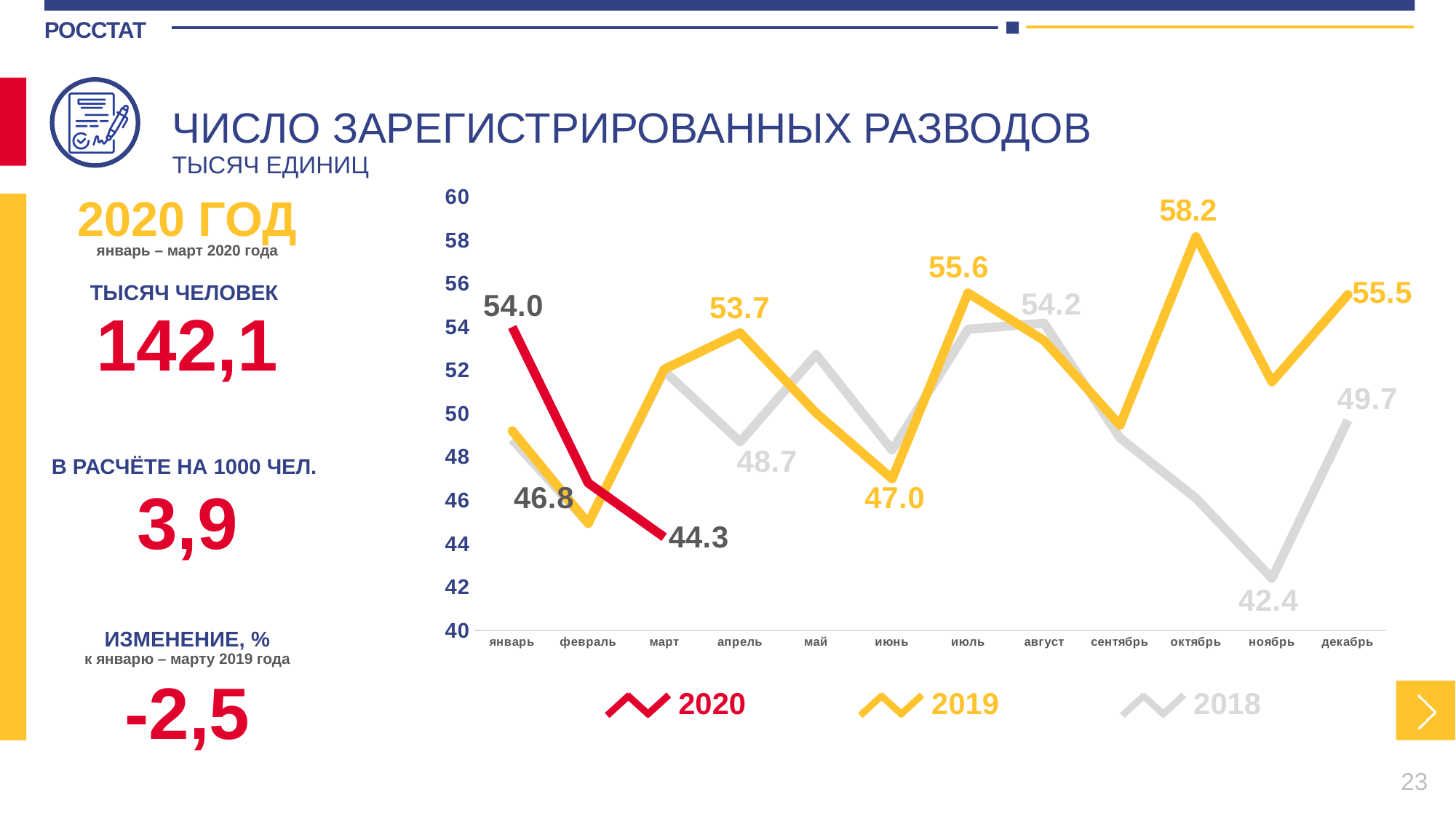
In which month does the 2019 series reach its highest value? октябрь What is the value for the 2020 series in январь (January)? 54.0 What is the value for the 2019 series in октябрь (October)? 58.2 In which month does the 2018 series reach its lowest value? ноябрь What type of chart is shown on the slide? line chart How many series does the chart legend list? 3 Is the value for the 2019 series in сентябрь greater or less than 52? less What is the difference between the 2020 values for январь (54.0) and март (44.3)? 9.7 What is the value for the 2018 series in ноябрь (November)? 42.4 What is the value for the 2020 series in март (March)? 44.3 How does the 2020 series change from январь to март? falls Which is larger: the 2019 value in июль or the 2018 value in август? 2019 value in июль